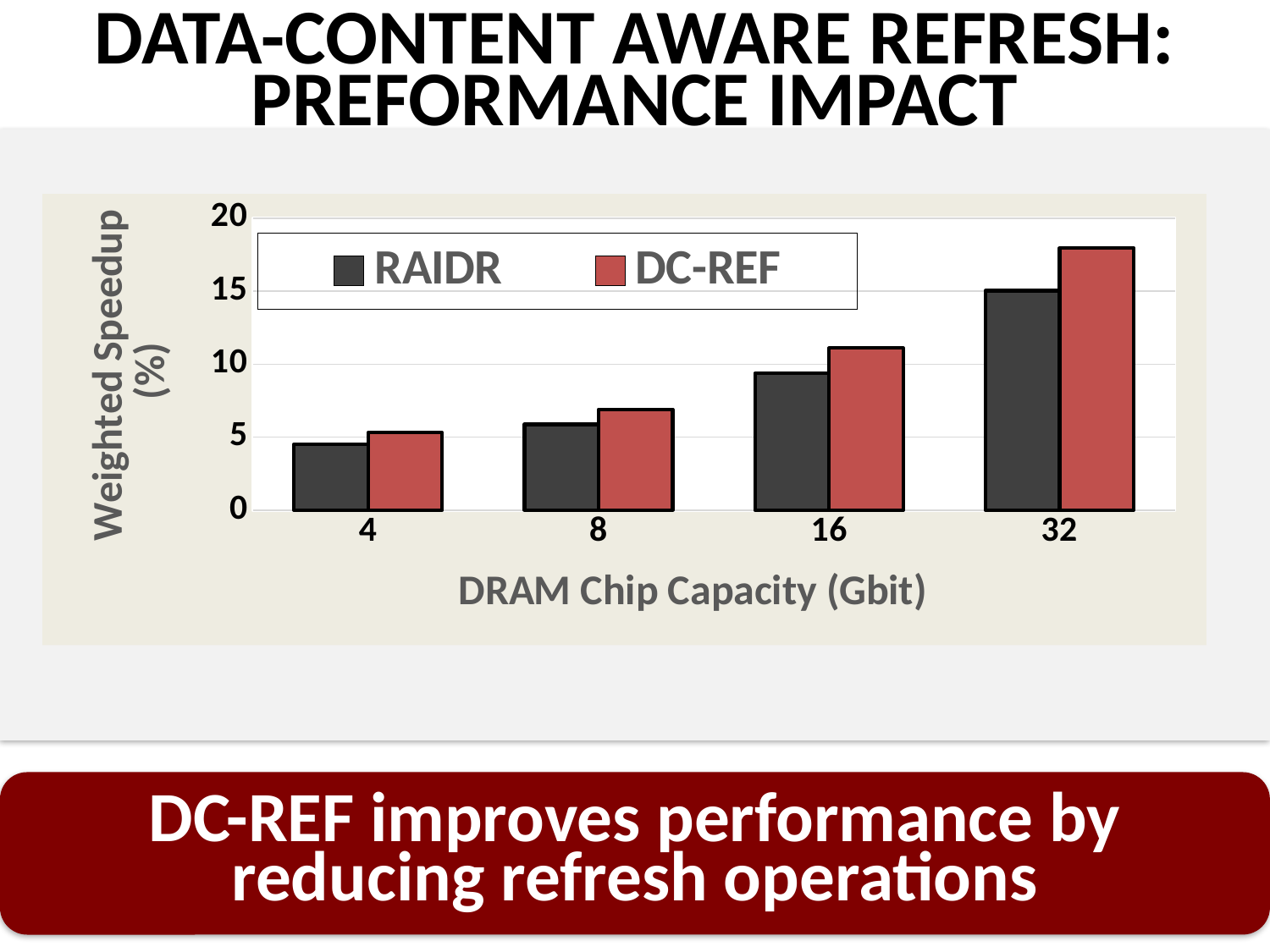
What kind of chart is shown on the slide? bar chart Is the DC-REF value at 32 Gbit greater or less than 15? greater How many series does the legend list? 2 What is the label of the x axis? DRAM Chip Capacity (Gbit) Which DRAM chip capacity has the highest DC-REF weighted speedup? 32 Is the RAIDR value at 16 Gbit greater or less than 10? less Do the weighted speedup values rise or fall as DRAM chip capacity increases? rise Is the DC-REF value at 16 Gbit greater or less than 10? greater At 32 Gbit, which series has the larger weighted speedup, RAIDR or DC-REF? DC-REF How many DRAM chip capacity categories are shown on the x axis? 4 Which series has the lowest bar at the 4 Gbit capacity? RAIDR